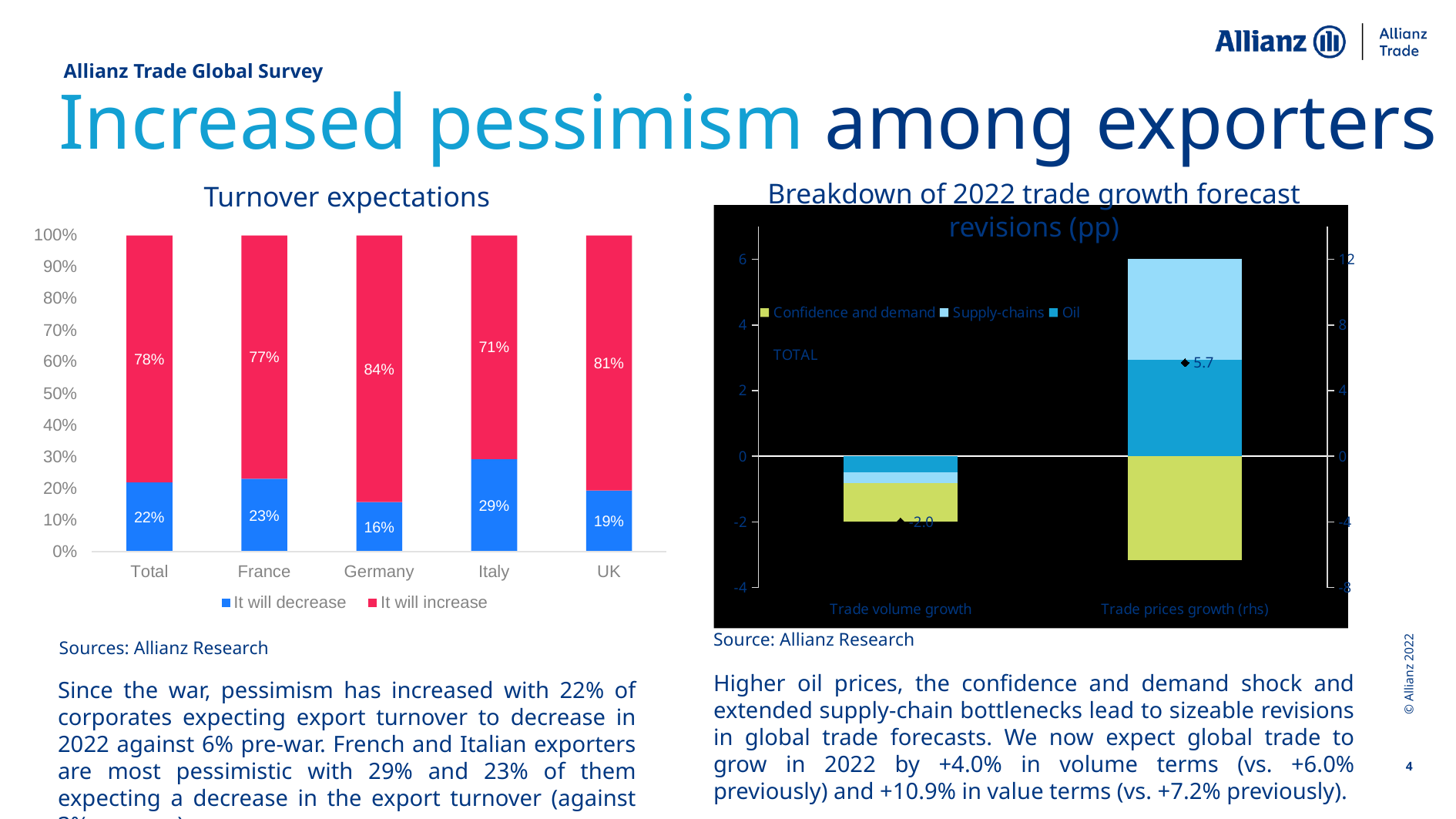
How many series does the legend of the Turnover expectations chart list? 2 In the Breakdown of 2022 trade growth forecast revisions chart, what is the TOTAL value for Trade volume growth? -2.0 In the Turnover expectations chart, which category has the lowest share saying 'It will decrease'? Germany In the Turnover expectations chart, which category has the highest share saying 'It will decrease'? Italy How many entries does the legend of the Breakdown of 2022 trade growth forecast revisions chart list? 4 What kind of chart is the Turnover expectations chart? Stacked bar chart In the Turnover expectations chart, what percentage of Italian exporters say turnover will decrease? 29% In the Turnover expectations chart, what percentage of German exporters say turnover will increase? 84% In the Turnover expectations chart, what is the difference between the 'It will decrease' shares for Italy and Germany? 13% In the Turnover expectations chart, is the 'It will increase' share larger for the UK or for France? UK How many categories are shown on the x axis of the Turnover expectations chart? 5 In the Breakdown of 2022 trade growth forecast revisions chart, what is the TOTAL value for Trade prices growth (rhs)? 5.7